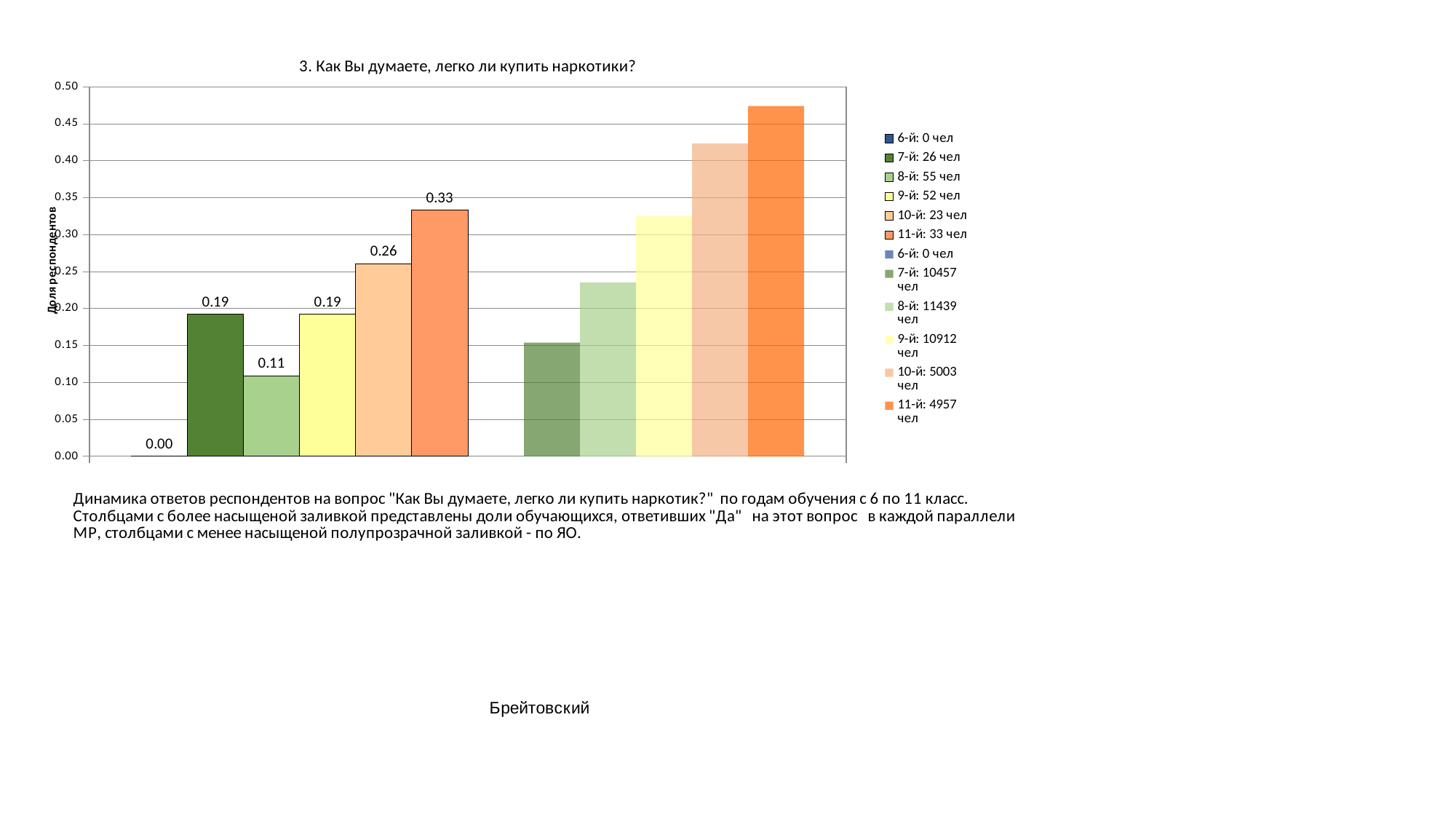
Is the value for the 11th grade (11-й: 4957 чел) bar in the lighter (ЯО) group greater or less than 0.45? greater What type of chart is shown on the slide? bar chart What is the labelled value for the 10th grade (10-й: 23 чел) bar in the saturated (МР) group? 0.26 What is the labelled value for the 11th grade (11-й: 33 чел) bar in the saturated (МР) group? 0.33 Is the value for the 7th grade (7-й: 10457 чел) bar in the lighter (ЯО) group greater or less than 0.20? less Among the labelled saturated (МР) bars, which grade has the highest value? 11-й What is the labelled value for the 6th grade (6-й: 0 чел) bar in the saturated (МР) group? 0.00 Which is larger in the saturated (МР) group: the labelled value for the 7th grade or the 8th grade? 7th grade (0.19) What is the title of the chart? 3. Как Вы думаете, легко ли купить наркотики? What is the labelled value for the 8th grade (8-й: 55 чел) bar in the saturated (МР) group? 0.11 What is the difference between the labelled values for the 11th grade (0.33) and the 10th grade (0.26) in the saturated (МР) group? 0.07 How many entries does the chart legend list? 12